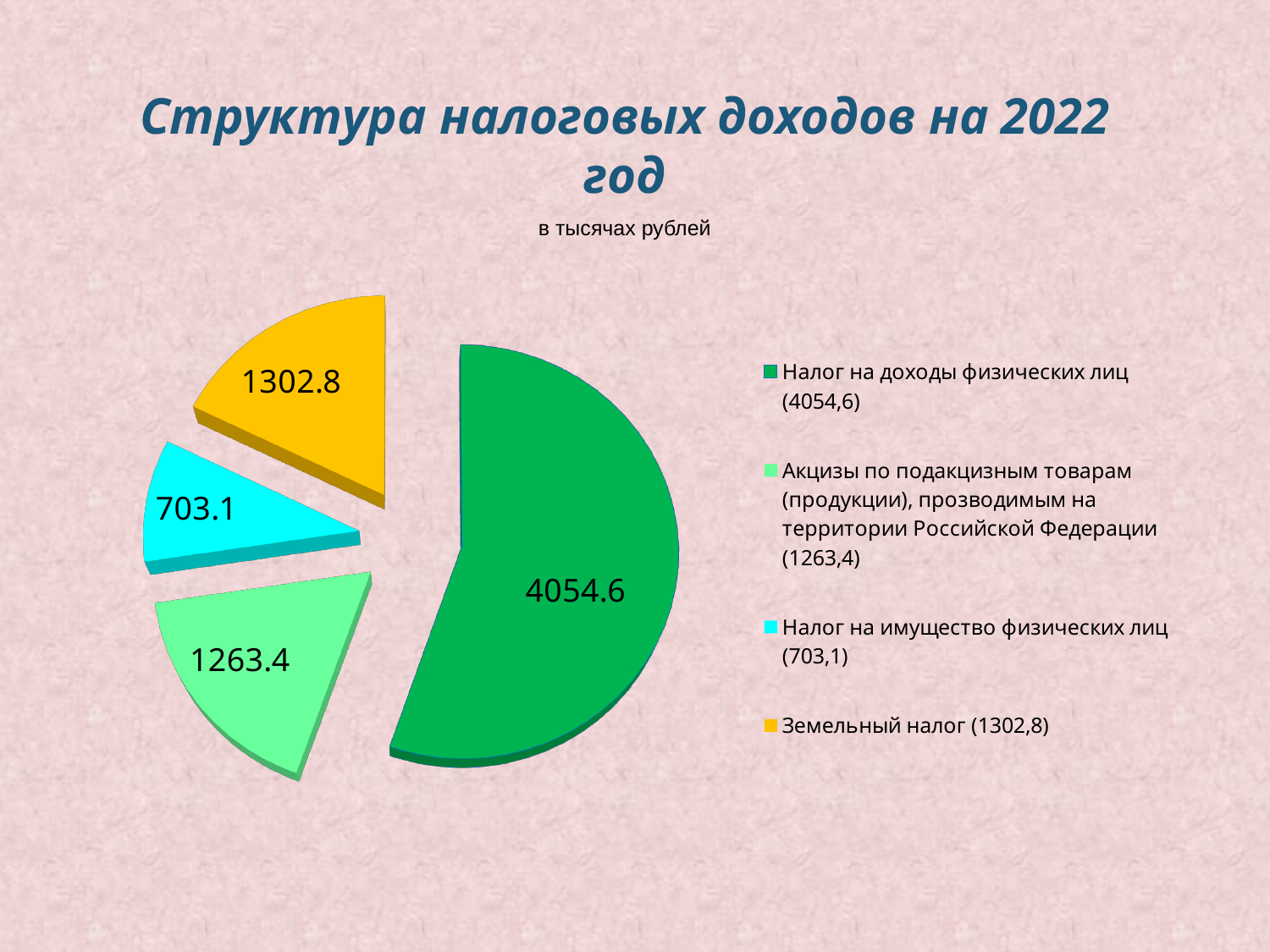
What kind of chart is shown on the slide? pie chart Which is larger, Земельный налог or Акцизы по подакцизным товарам? Земельный налог What is the difference between the values for Земельный налог and Налог на имущество физических лиц? 599.7 Which category has the largest slice of the pie? Налог на доходы физических лиц How many slices does the pie chart have? 4 What is the difference between the values for Налог на доходы физических лиц and Акцизы по подакцизным товарам? 2791.2 What is the value for Акцизы по подакцизным товарам (продукции), прозводимым на территории Российской Федерации? 1263.4 What is the value for Земельный налог? 1302.8 In what units are the values on the chart given, according to the slide? в тысячах рублей Which category has the smallest slice of the pie? Налог на имущество физических лиц What is the value for Налог на доходы физических лиц? 4054.6 What is the value for Налог на имущество физических лиц? 703.1